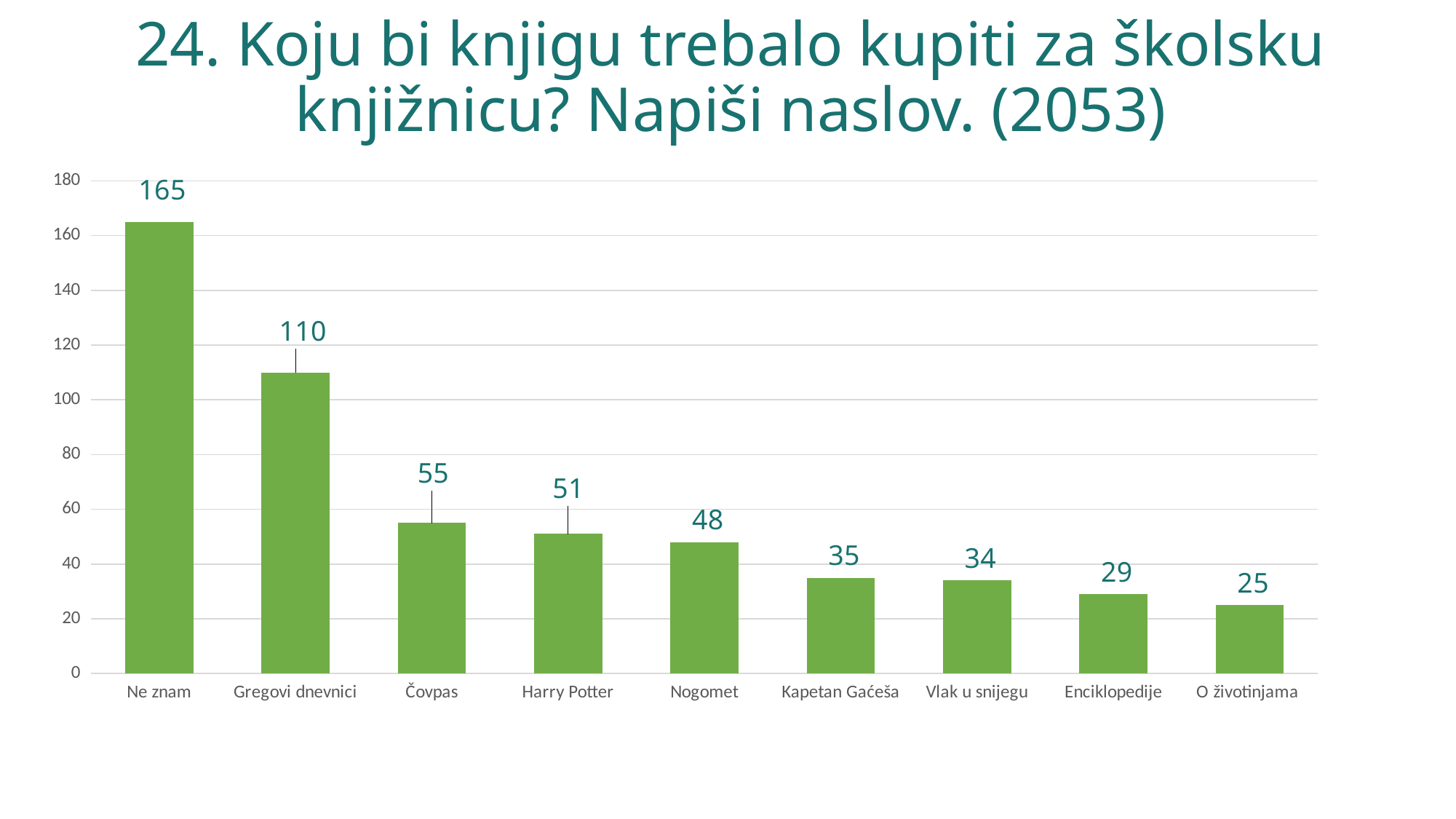
What is the value for Enciklopedije? 29 What is the value for Harry Potter? 51 What kind of chart is shown on the slide? bar chart What is the difference between the values for Ne znam and Gregovi dnevnici? 55 How many categories are shown on the x axis? 9 Is the value for Nogomet greater or less than 60? less Which is larger, the value for Kapetan Gaćeša or the value for Enciklopedije? Kapetan Gaćeša What is the value for Gregovi dnevnici? 110 Which category has the lowest value? O životinjama Do the values rise or fall from left to right along the x axis? fall Which category has the highest value? Ne znam What is the difference between the values for Čovpas and Nogomet? 7